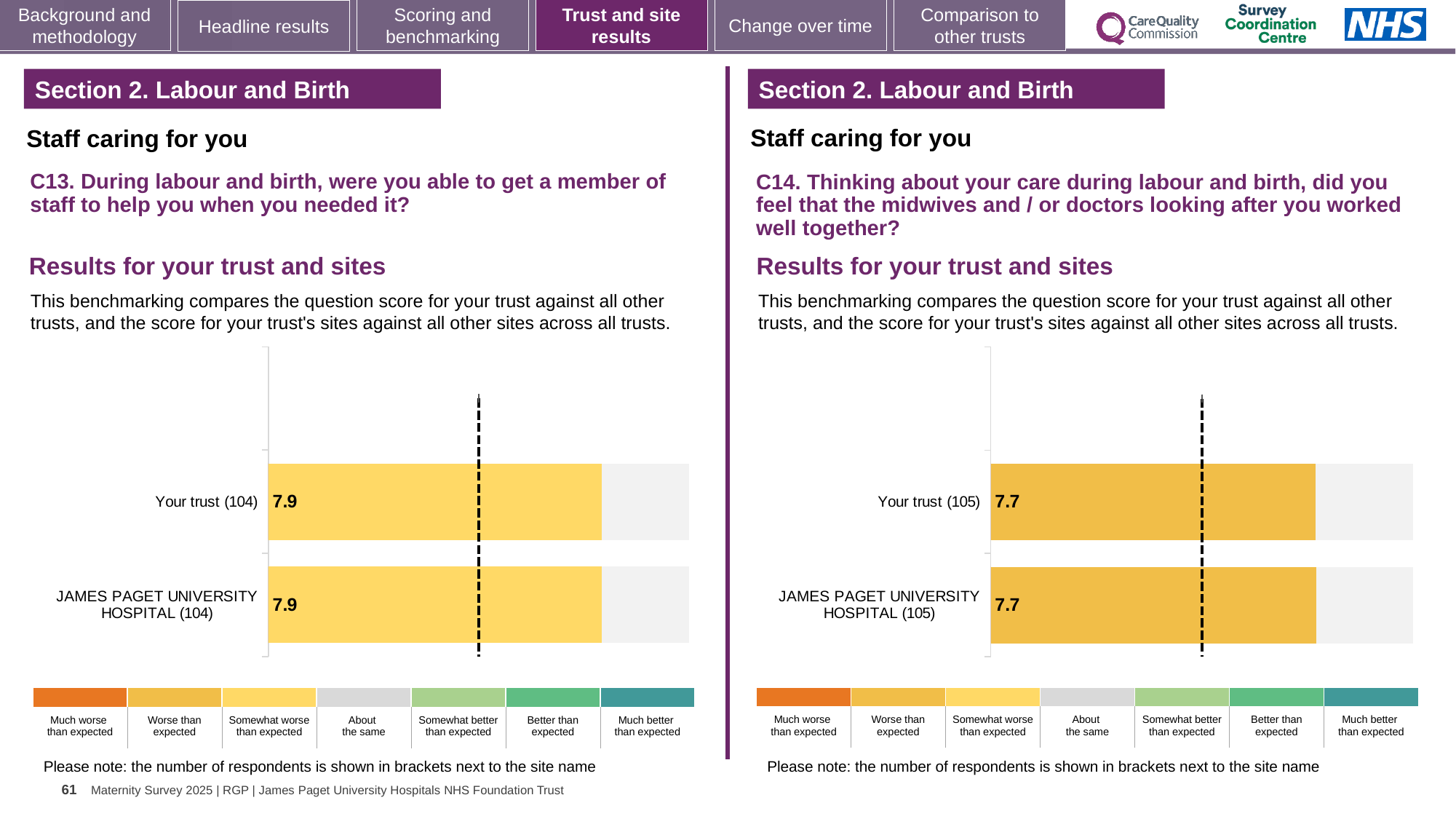
In the C14 chart on the right, what is the difference between the Your trust score and the James Paget University Hospital score? 0.0 In the C13 chart on the left, what is the score for Your trust? 7.9 What kind of chart is the C13 chart on the left? Bar chart In the C13 chart on the left, how many respondents are shown in brackets for Your trust? 104 In the C14 chart on the right, what is the score for Your trust? 7.7 In the C14 chart on the right, how many respondents are shown in brackets for James Paget University Hospital? 105 In the C14 chart on the right, how many bars are plotted? 2 In the C14 chart on the right, what is the score for James Paget University Hospital? 7.7 In the C13 chart on the left, what is the score for James Paget University Hospital? 7.9 In the C13 chart on the left, which benchmark category does the colour of the bars correspond to according to the legend? Somewhat worse than expected In the C13 chart on the left, how many bars are plotted? 2 In the C13 chart on the left, what is the difference between the Your trust score and the James Paget University Hospital score? 0.0